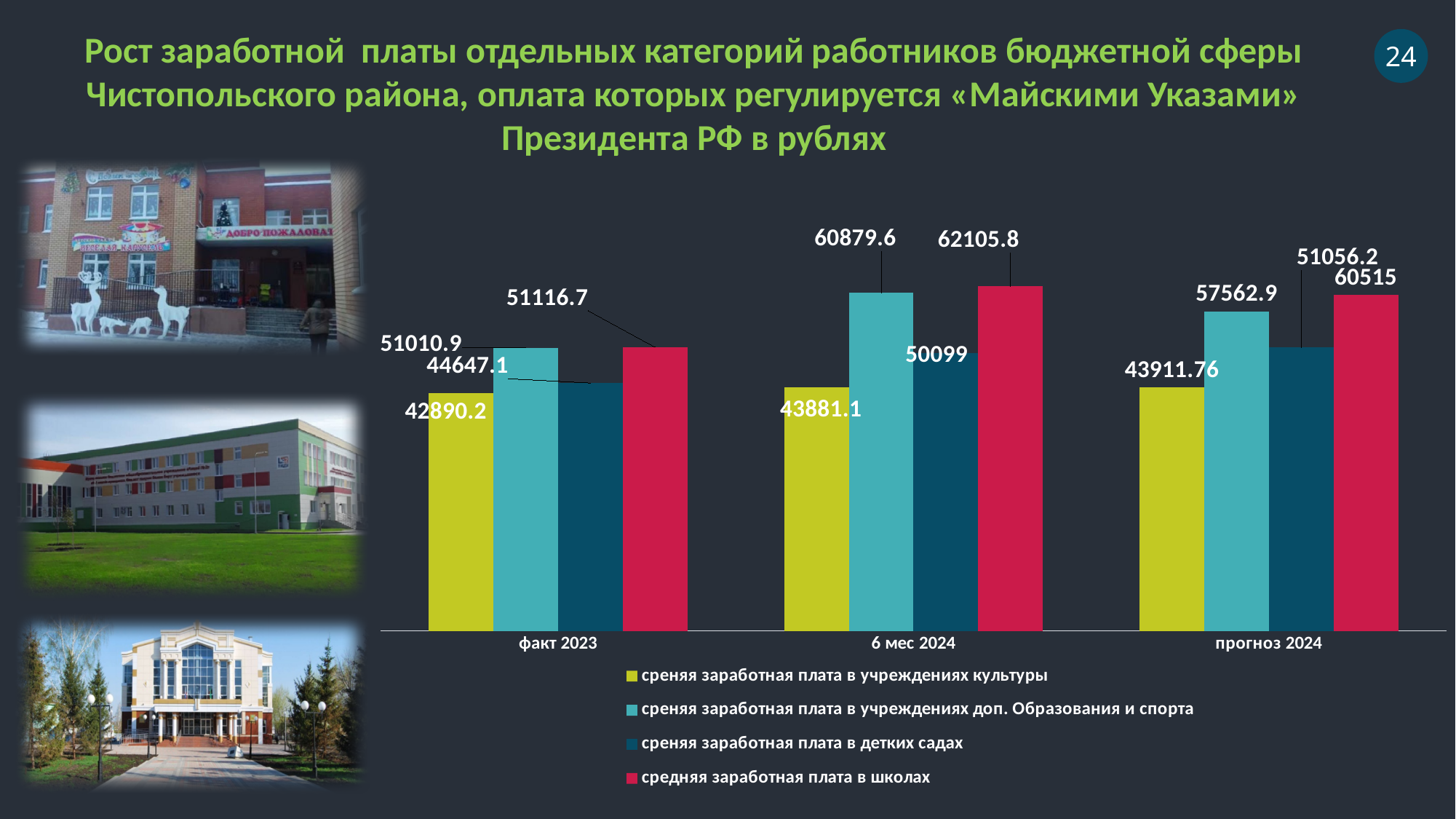
Which series has the highest value in the 6 мес 2024 group? средняя заработная плата в школах What is the average salary in institutions of additional education and sport for прогноз 2024? 57562.9 What type of chart is shown on the slide? bar chart Which series has the lowest value in the прогноз 2024 group? среняя заработная плата в учреждениях культуры What is the difference between the school salary and the additional education and sport salary for 6 мес 2024? 1226.2 How many categories are shown on the x axis? 3 Which is larger for прогноз 2024: the salary in schools or the salary in kindergartens? средняя заработная плата в школах What is the average salary in kindergartens (детских садах) for прогноз 2024? 51056.2 What is the average salary in schools (средняя заработная плата в школах) for 6 мес 2024? 62105.8 What is the average salary in cultural institutions (учреждениях культуры) for факт 2023? 42890.2 How many series does the legend list? 4 Do the values for the school salary series rise or fall from факт 2023 to 6 мес 2024? rise